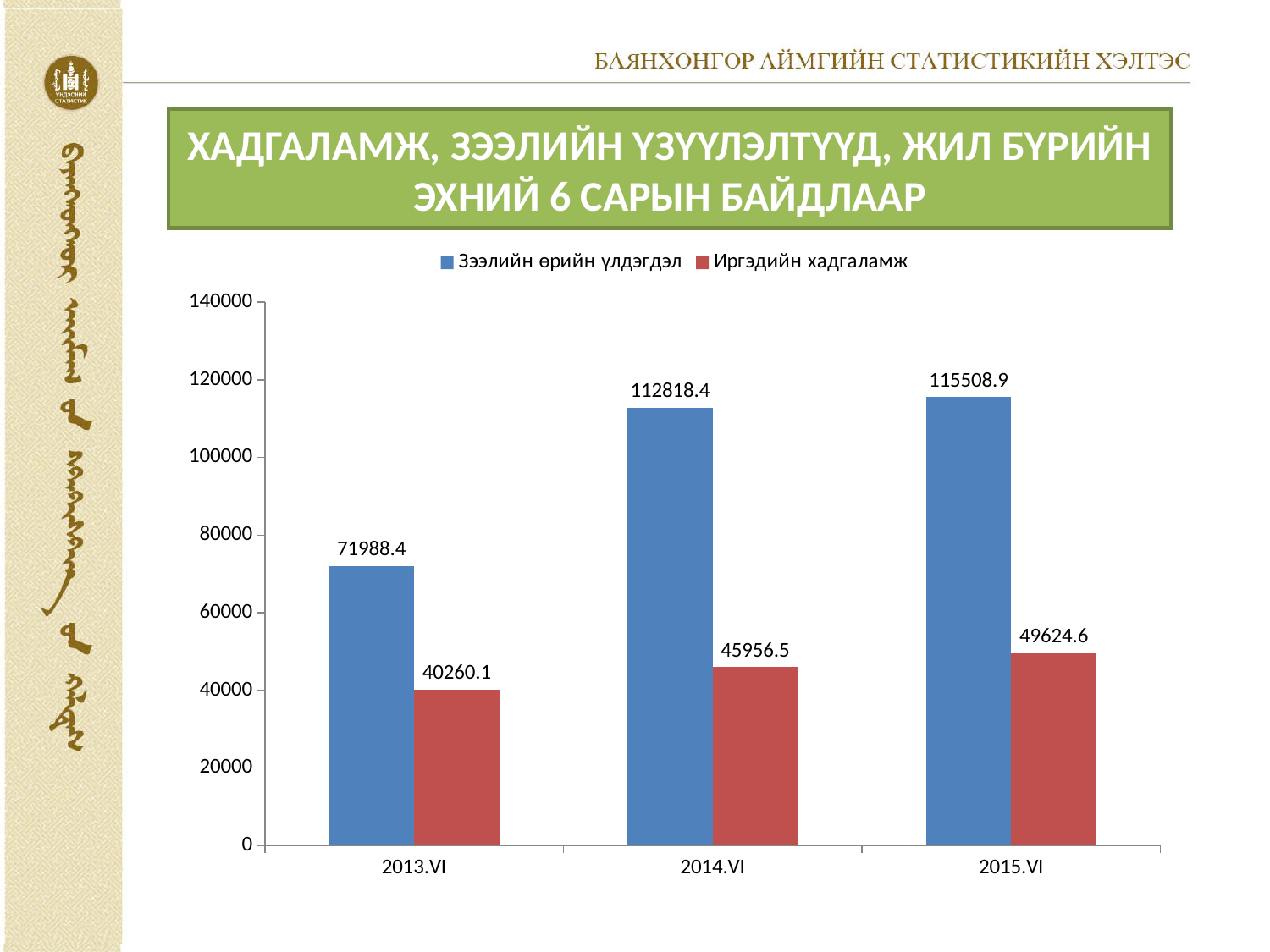
How many series does the legend list? 2 In which period is Иргэдийн хадгаламж lowest? 2013.VI In which period is Зээлийн өрийн үлдэгдэл highest? 2015.VI What kind of chart is shown on the slide? Bar chart How many periods are shown on the x axis? 3 Does Иргэдийн хадгаламж rise or fall from 2013.VI to 2015.VI? Rise What is the value of Зээлийн өрийн үлдэгдэл for 2013.VI? 71988.4 What is the value of Иргэдийн хадгаламж for 2015.VI? 49624.6 Which is larger in 2013.VI: Зээлийн өрийн үлдэгдэл or Иргэдийн хадгаламж? Зээлийн өрийн үлдэгдэл What is the difference between Зээлийн өрийн үлдэгдэл and Иргэдийн хадгаламж in 2015.VI? 65884.3 What is the difference between Зээлийн өрийн үлдэгдэл in 2014.VI and 2013.VI? 40830.0 What is the value of Иргэдийн хадгаламж for 2014.VI? 45956.5